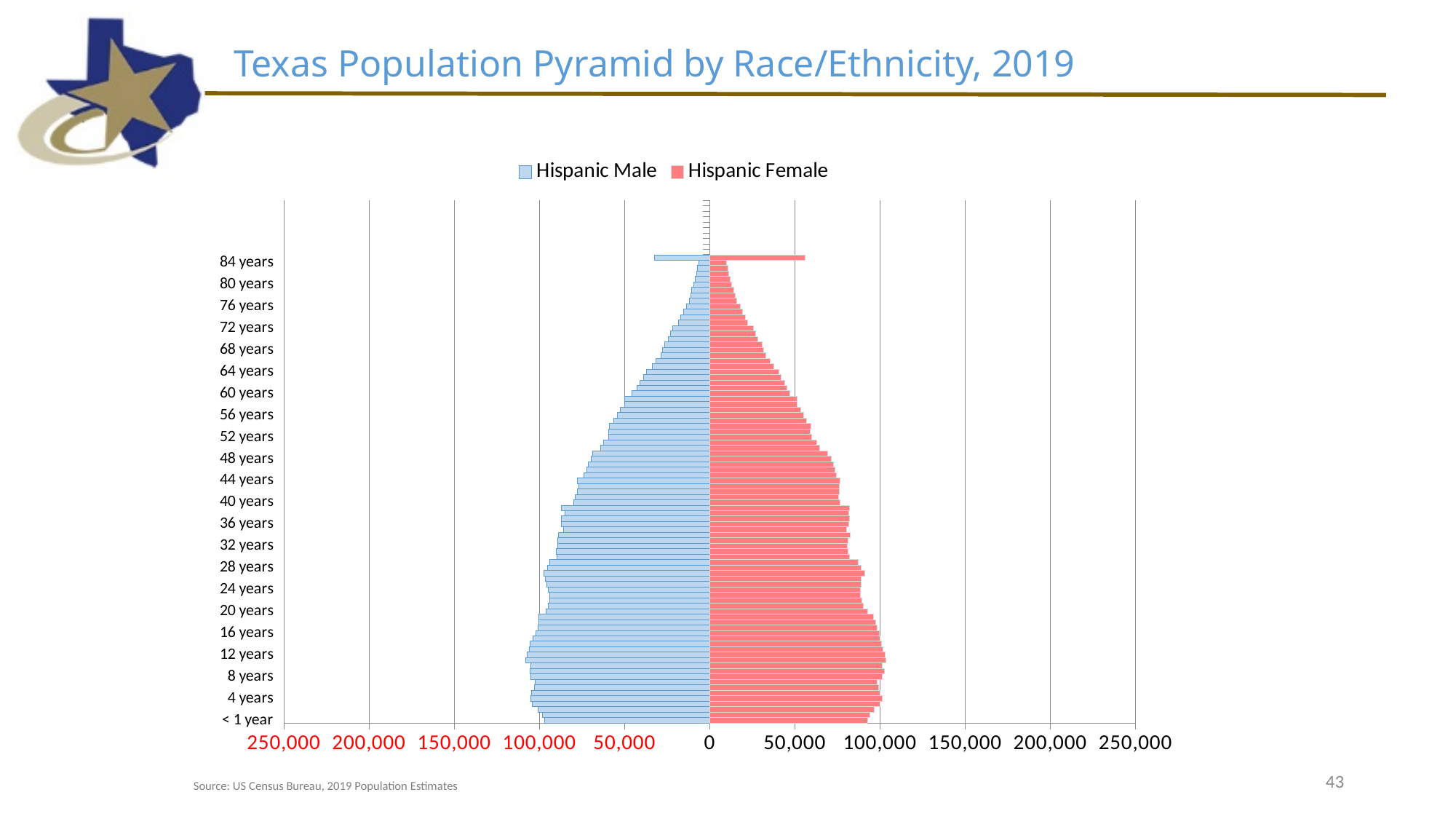
Is the value for Hispanic Male at 84 years greater or less than 50,000? less For Hispanic Male, which is larger: the value at 12 years or the value at 60 years? 12 years Is the value for Hispanic Female at 40 years greater or less than 100,000? less What kind of chart is shown on the slide? Bar chart (population pyramid) Is the value for Hispanic Male at 64 years greater or less than 50,000? less Which two series are listed in the chart legend? Hispanic Male and Hispanic Female Do the Hispanic Male bars generally get longer or shorter as age increases from 28 years to 80 years? shorter How many series does the legend list? 2 At 84 years, which is larger: the Hispanic Male value or the Hispanic Female value? Hispanic Female What colour are the Hispanic Female bars? Red/pink